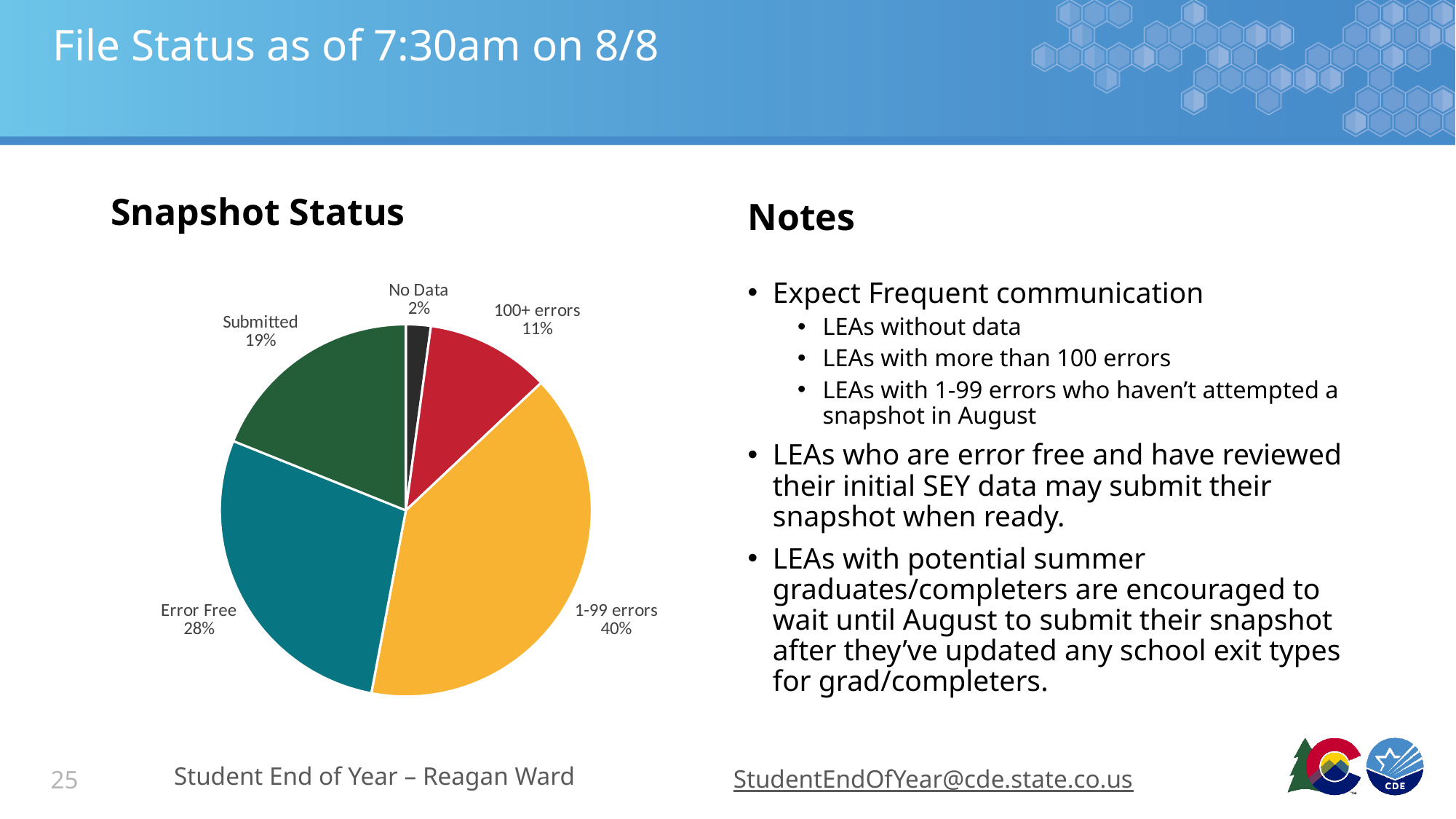
What percentage of the Snapshot Status pie is 1-99 errors? 40% What percentage of the Snapshot Status pie is Submitted? 19% Which category has the largest slice in the Snapshot Status pie chart? 1-99 errors What percentage of the Snapshot Status pie is Error Free? 28% What is the difference in percentage points between the 1-99 errors slice and the Error Free slice? 12 What colour is the 1-99 errors slice in the Snapshot Status pie chart? yellow/orange What type of chart is shown under the heading Snapshot Status? pie chart What percentage of the Snapshot Status pie is No Data? 2% What percentage of the Snapshot Status pie is 100+ errors? 11% How many categories are shown in the Snapshot Status pie chart? 5 Which category has the smallest slice in the Snapshot Status pie chart? No Data Which slice is larger in the Snapshot Status pie chart, Submitted or 100+ errors? Submitted